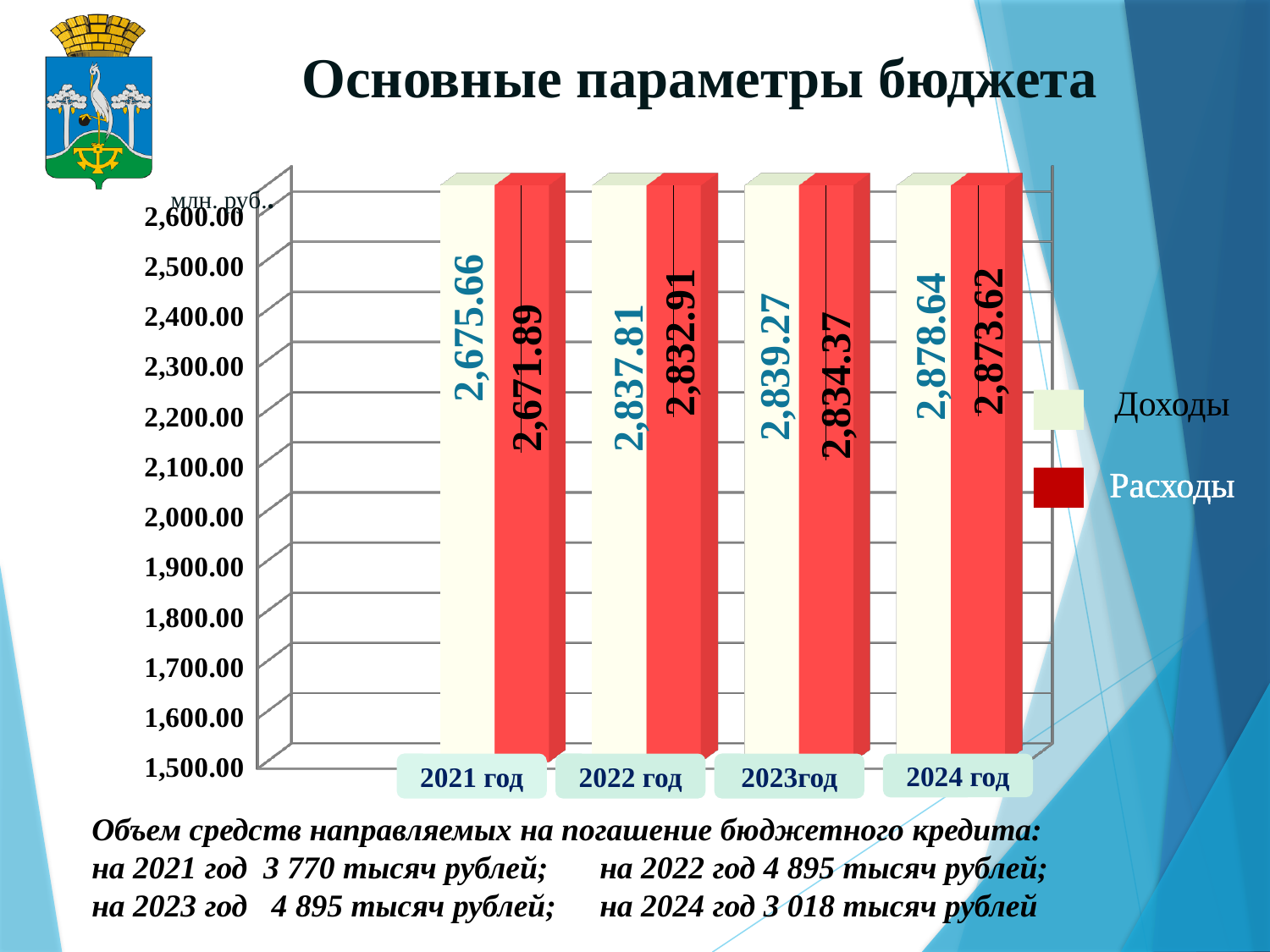
Which year has the lowest value of Расходы? 2021 год What is the difference between Доходы and Расходы for 2024 год? 5.02 Which is larger for 2022 год: Доходы or Расходы? Доходы How many series does the legend list? 2 What is the difference between Доходы and Расходы for 2021 год? 3.77 How many years are shown on the x axis of the chart? 4 What is the value of Расходы for 2023год? 2,834.37 What is the value of Доходы for 2024 год? 2,878.64 Which year has the highest value of Доходы? 2024 год What is the value of Доходы for 2021 год? 2,675.66 What is the value of Расходы for 2022 год? 2,832.91 What kind of chart is shown on the slide? Bar chart